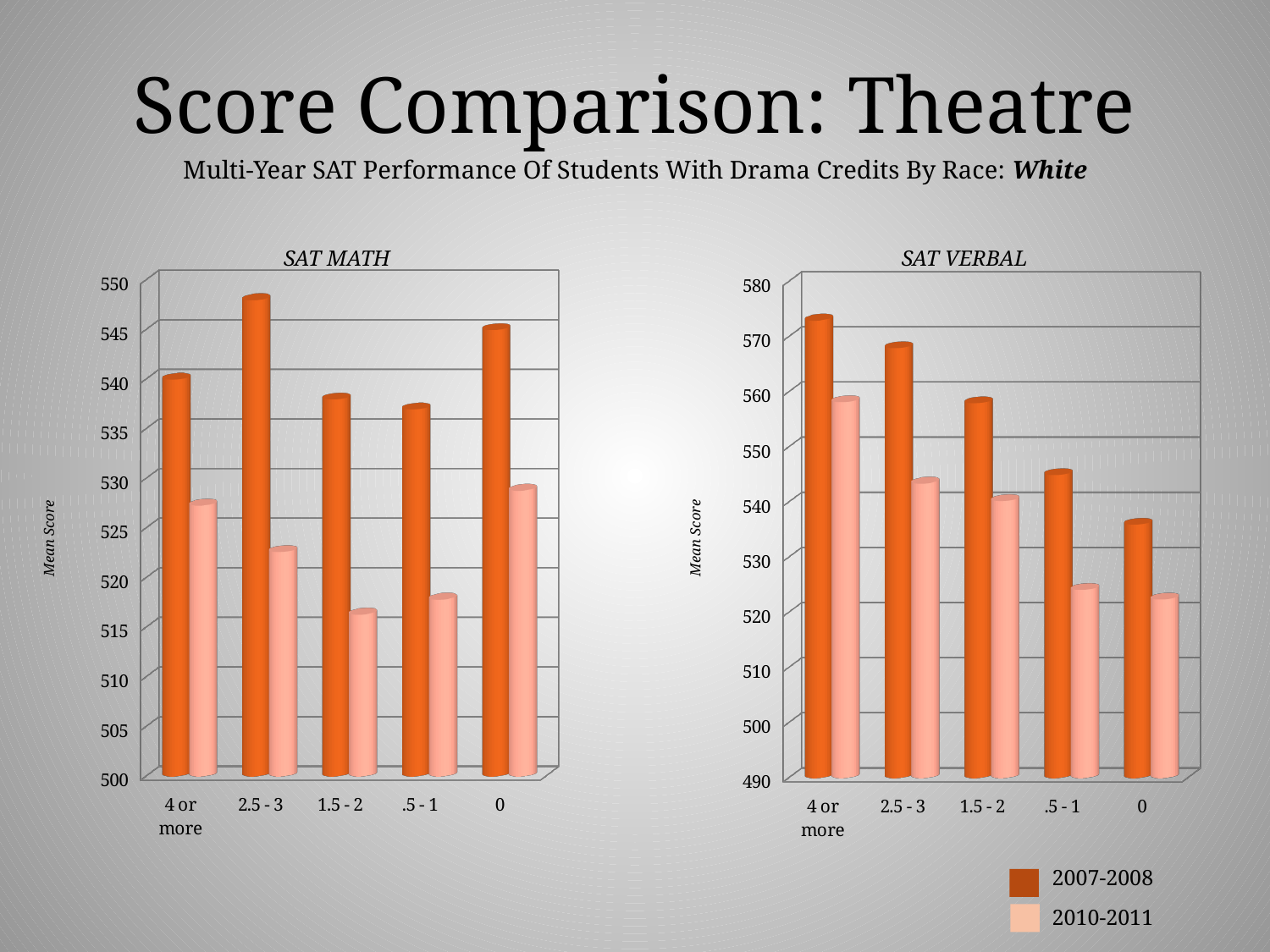
What kind of chart is the SAT MATH chart? bar chart In the SAT VERBAL chart, which category has the lowest 2007-2008 value? 0 In the SAT MATH chart, which category has the highest 2007-2008 value? 2.5 - 3 What is the label on the vertical axis of the SAT MATH chart? Mean Score In the SAT VERBAL chart, is the 2010-2011 value for 0 greater or less than 530? less In the SAT MATH chart, which category has the lowest 2010-2011 value? 1.5 - 2 In the SAT VERBAL chart, which category has the highest 2007-2008 value? 4 or more How many series does the legend list? 2 In the SAT VERBAL chart, which is larger for the 4 or more category: the 2007-2008 value or the 2010-2011 value? 2007-2008 In the SAT VERBAL chart, do the 2007-2008 values rise or fall from left to right along the x axis? fall How many categories are shown on the x axis of the SAT VERBAL chart? 5 In the SAT MATH chart, is the 2007-2008 value for 2.5 - 3 greater or less than 545? greater